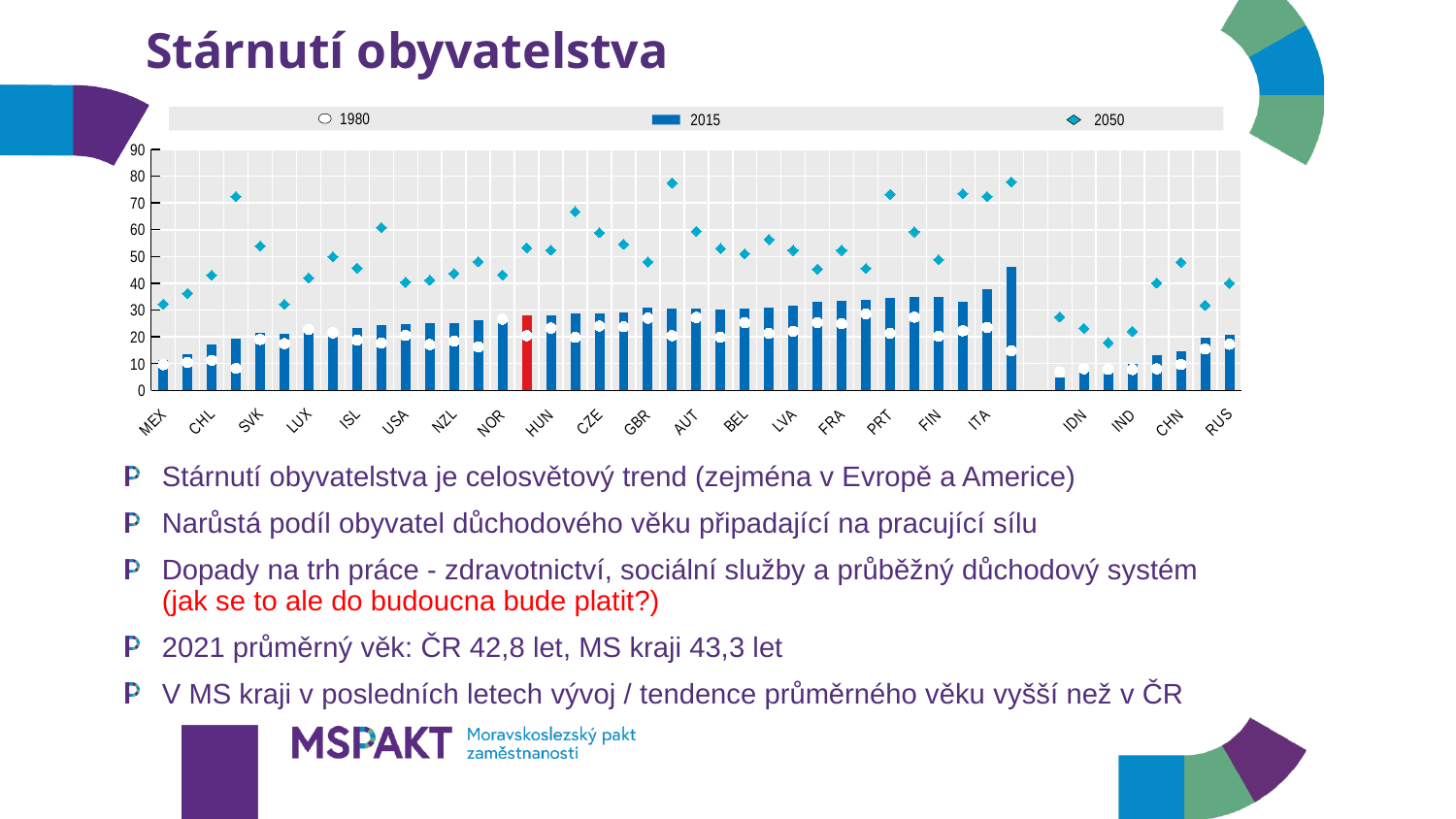
What kind of chart is shown on the slide? bar chart Is the 2015 value for IDN greater or less than 10? less Which years are listed in the chart legend? 1980, 2015, 2050 Is the 2050 value for IND greater or less than 30? less Is the 2015 value for ITA greater or less than 30? greater How many series does the chart legend list? 3 Which series is drawn as bars in the chart? 2015 Do the 2015 bars generally rise or fall from MEX on the left to ITA on the right? rise Which has the larger 2050 value, ITA or IND? ITA